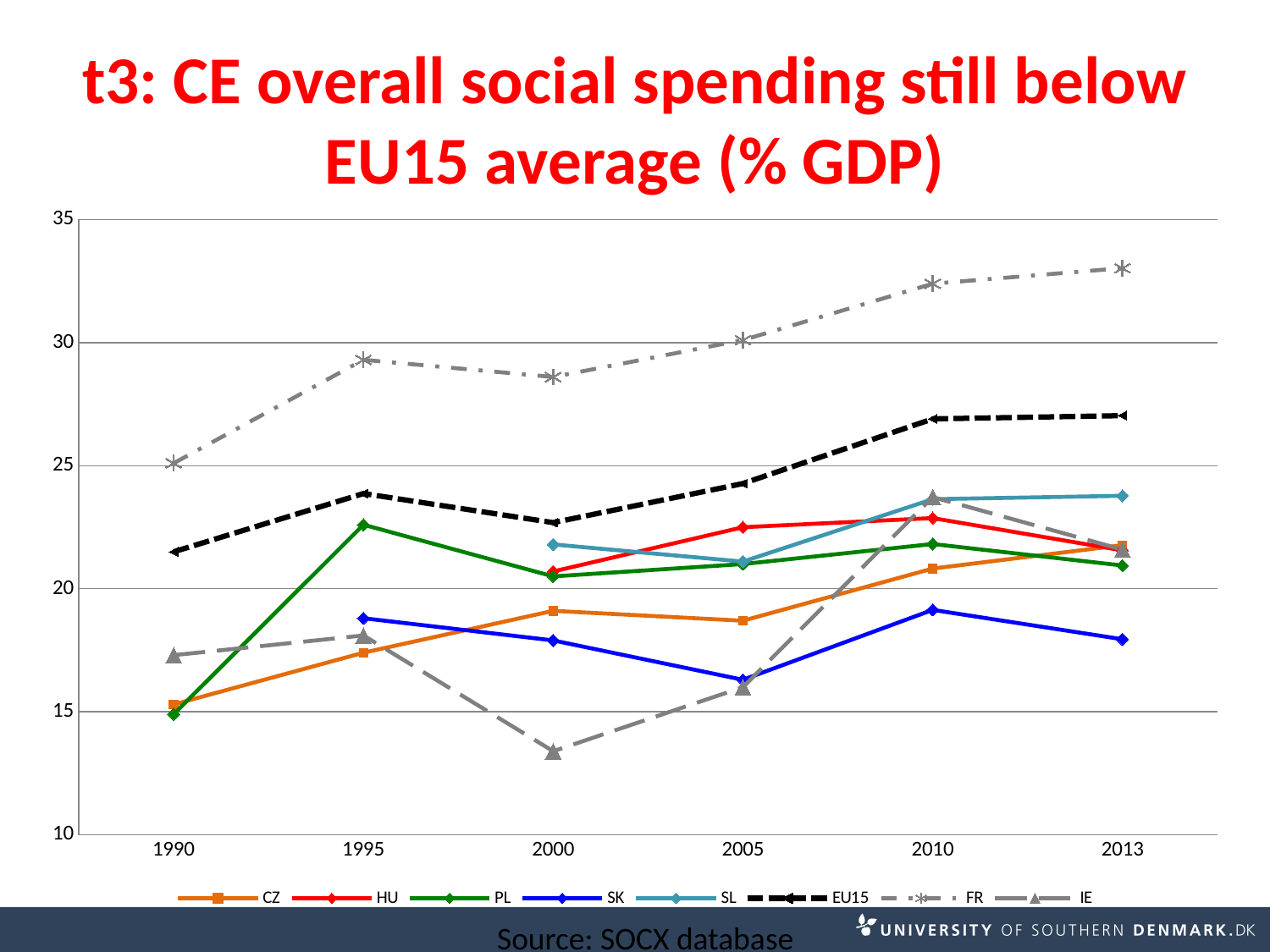
Which series has the highest value in 2013? FR Is the value for FR in 2013 greater or less than 30? greater Which series has the lowest value in 2000? IE Is the value for SK in 2005 greater or less than 20? less How many series does the legend list? 8 What is the title of the chart on the slide? t3: CE overall social spending still below EU15 average (% GDP) Does the EU15 line rise or fall overall from 1990 to 2013? rise In 2010, which is larger, the value for EU15 or the value for SL? EU15 Is the value for IE in 2000 greater or less than 15? less How many years are shown on the x axis? 6 Which series has the lowest value in 2013? SK What kind of chart is shown on the slide? line chart